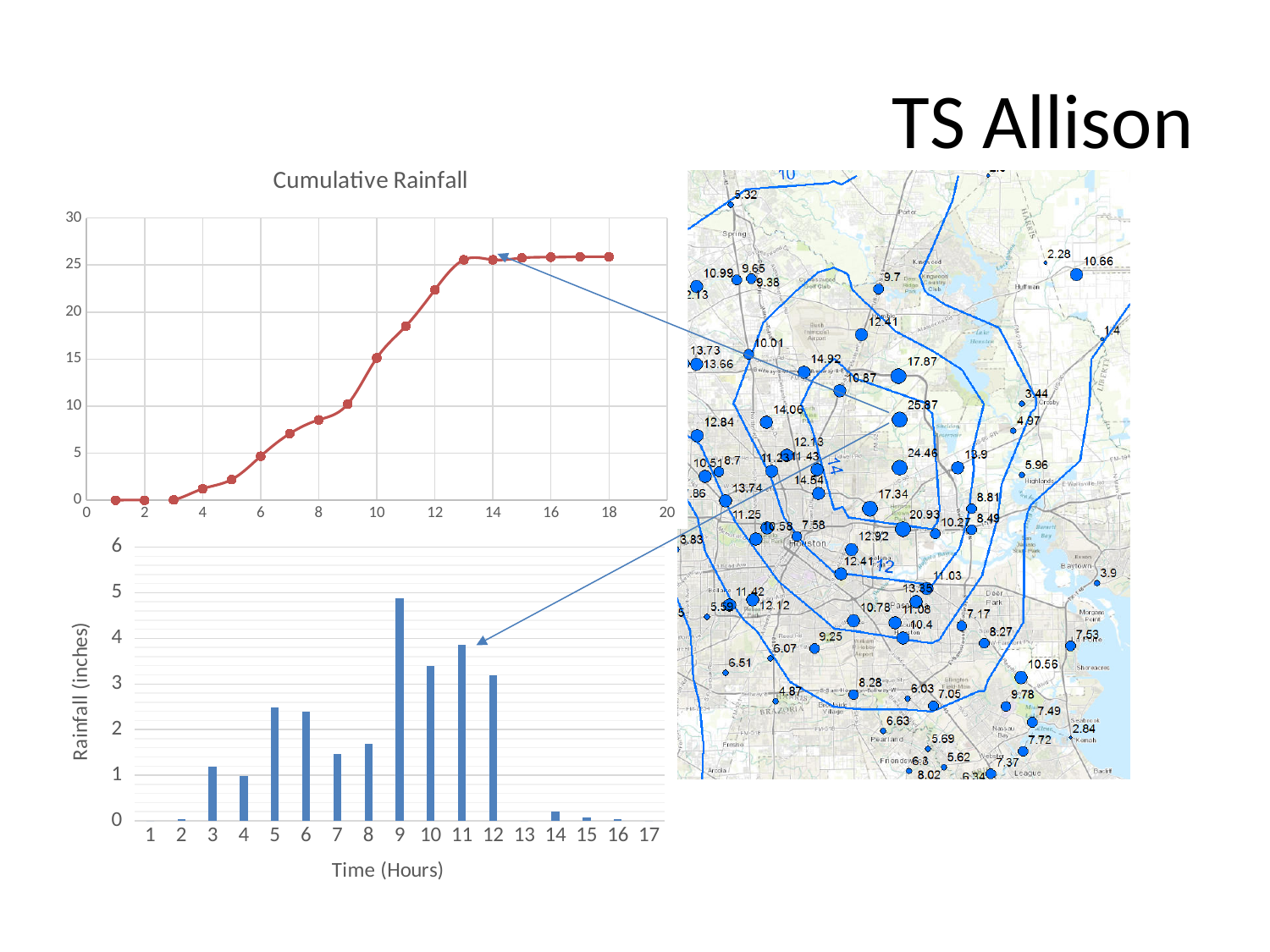
In the top "Cumulative Rainfall" chart, is the value at hour 12 greater or less than 20? greater What kind of chart is the bottom chart with the x axis "Time (Hours)"? bar chart In the bottom bar chart, is the value for hour 5 greater or less than 2? greater In the bottom bar chart, is the value for hour 7 greater or less than 2? less What kind of chart is the top chart titled "Cumulative Rainfall"? line chart In the bottom bar chart, which hour has the highest rainfall? 9 In the top "Cumulative Rainfall" chart, do the values rise or fall from hour 1 to hour 13? rise How many data points are plotted in the top "Cumulative Rainfall" chart? 18 In the bottom bar chart, which is larger, the value for hour 9 or the value for hour 11? hour 9 What is the y-axis label of the bottom bar chart? Rainfall (inches) In the bottom bar chart, which is larger, the value for hour 5 or the value for hour 7? hour 5